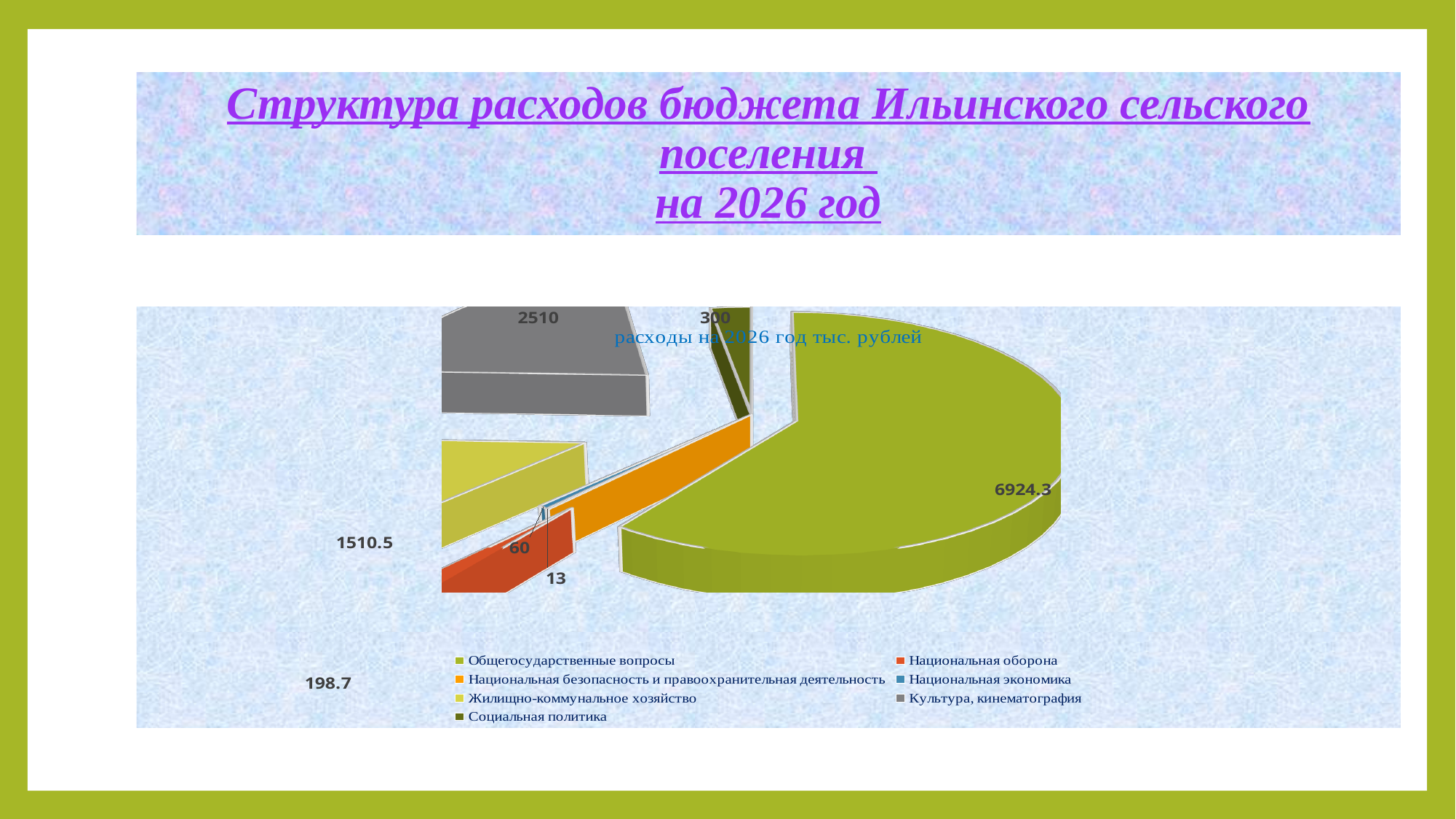
How many categories does the legend list? 7 Which is larger: the value for Социальная политика or the value for Национальная оборона? Социальная политика Which category has the largest slice of the pie? Общегосударственные вопросы What is the value for Жилищно-коммунальное хозяйство? 1510.5 Which category has the smallest slice of the pie? Национальная безопасность и правоохранительная деятельность What is the value for Культура, кинематография? 2510 What is the difference between the values for Культура, кинематография and Жилищно-коммунальное хозяйство? 999.5 What is the value for Общегосударственные вопросы? 6924.3 What kind of chart is shown on the slide? pie chart What is the value for Социальная политика? 300 What is the value for Национальная оборона? 198.7 What is the value for Национальная экономика? 60